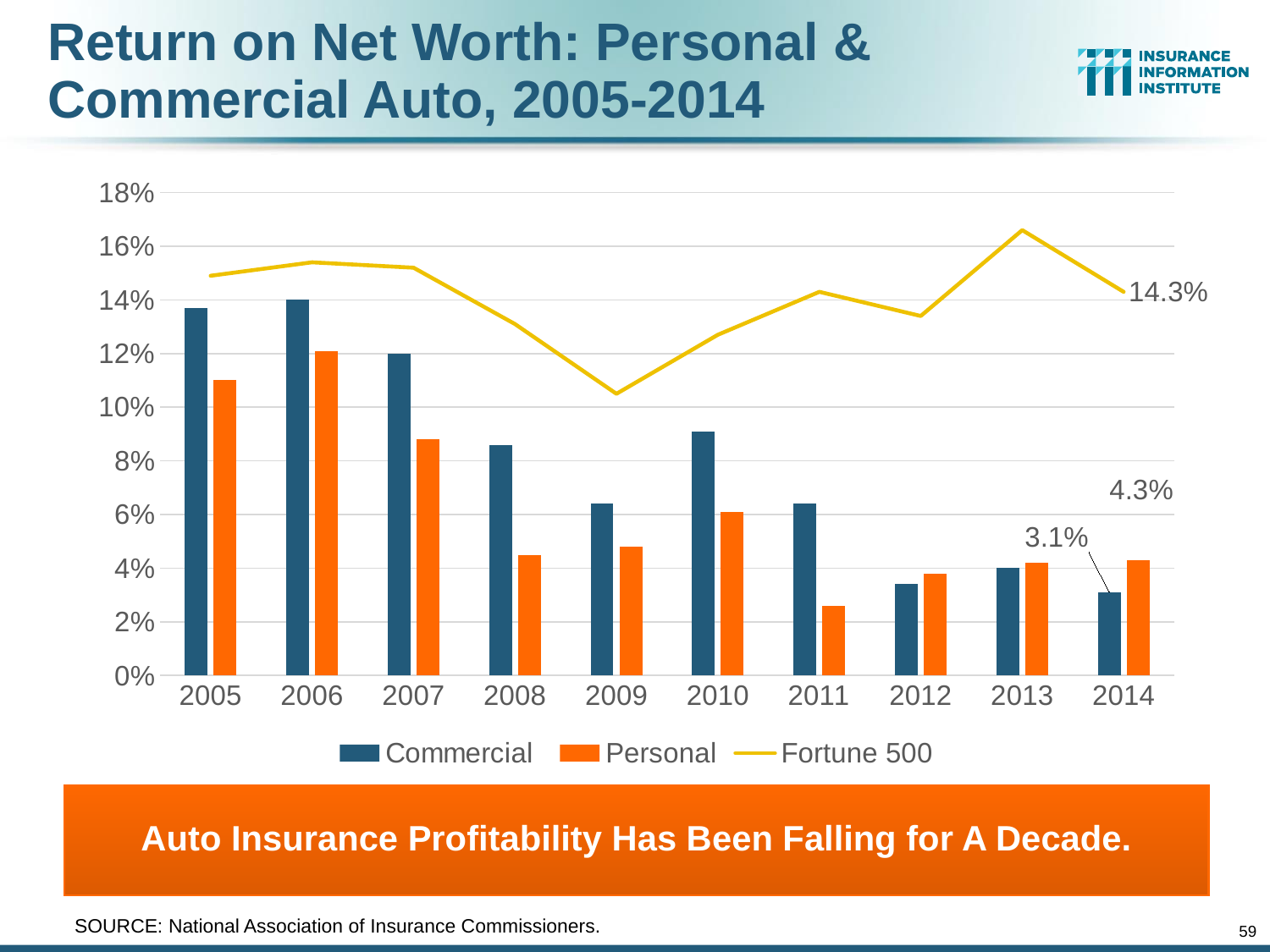
What is the Personal return on net worth in 2014? 4.3% In 2011, which is larger, the Commercial or the Personal value? Commercial Is the Fortune 500 value for 2009 greater or less than 12%? less Is the Commercial value for 2005 greater or less than 12%? greater In which year is the Personal series lowest? 2011 What is the Commercial return on net worth in 2014? 3.1% What is the Fortune 500 value in 2014? 14.3% In which year does the Fortune 500 line reach its highest point? 2013 How many years are shown on the x axis? 10 How many series does the legend list? 3 What is the difference between the Personal and Commercial values in 2014? 1.2 percentage points In which year is the Personal series highest? 2006